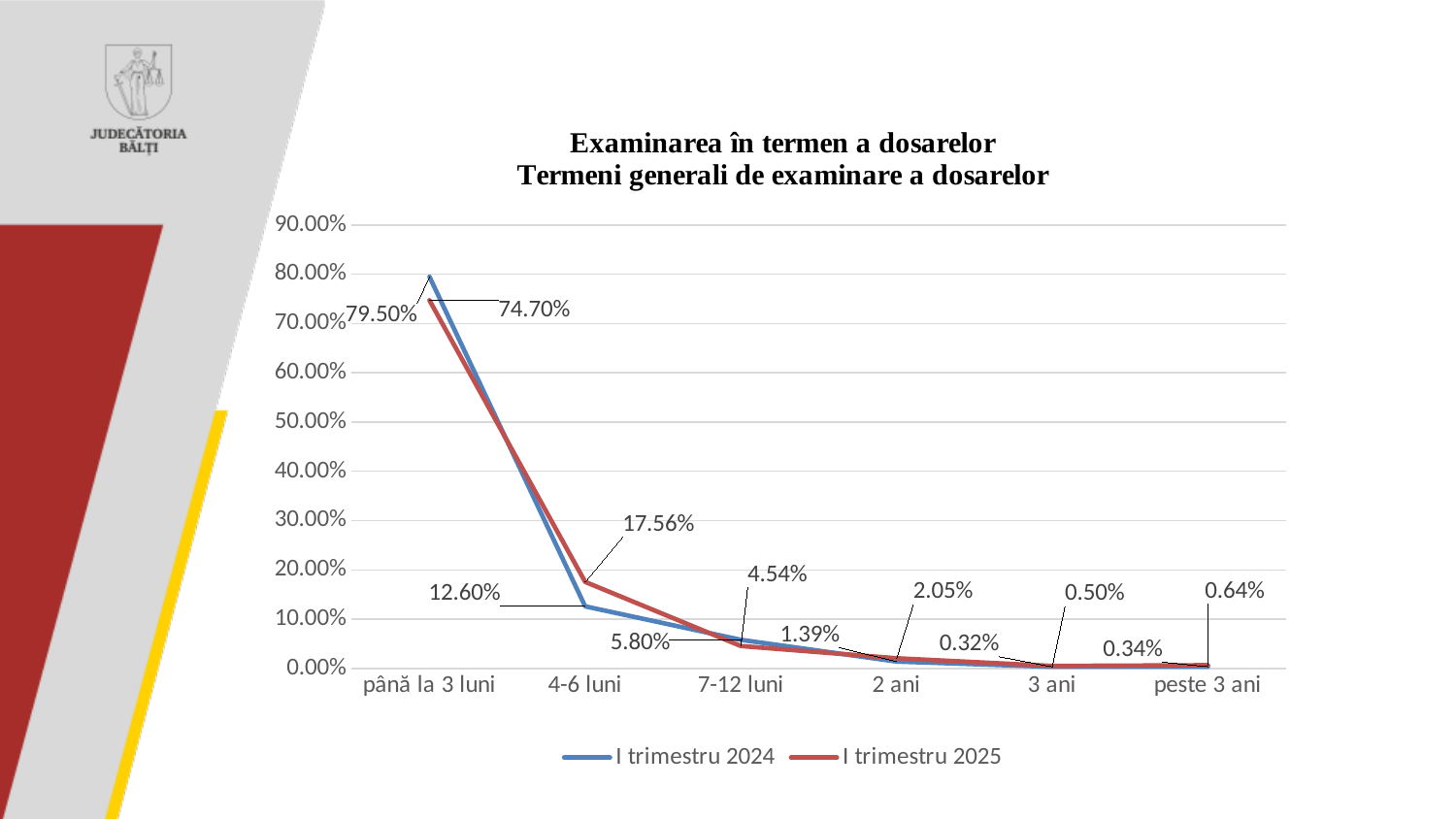
Do the values in the 'I trimestru 2024' series generally rise or fall from 'până la 3 luni' to '3 ani'? fall Which category has the lowest value in the 'I trimestru 2024' series? 3 ani What is the value for 'până la 3 luni' in the 'I trimestru 2024' series? 79.50% What is the value for 'peste 3 ani' in the 'I trimestru 2025' series? 0.64% What type of chart is shown on the slide? line chart For '4-6 luni', which series has the larger value, 'I trimestru 2024' or 'I trimestru 2025'? I trimestru 2025 What is the value for '4-6 luni' in the 'I trimestru 2025' series? 17.56% What is the difference between the 'I trimestru 2024' and 'I trimestru 2025' values for 'până la 3 luni'? 4.80% Which category has the highest value in the 'I trimestru 2025' series? până la 3 luni How many series does the legend list? 2 How many categories are shown on the x axis? 6 What is the value for '7-12 luni' in the 'I trimestru 2024' series? 5.80%